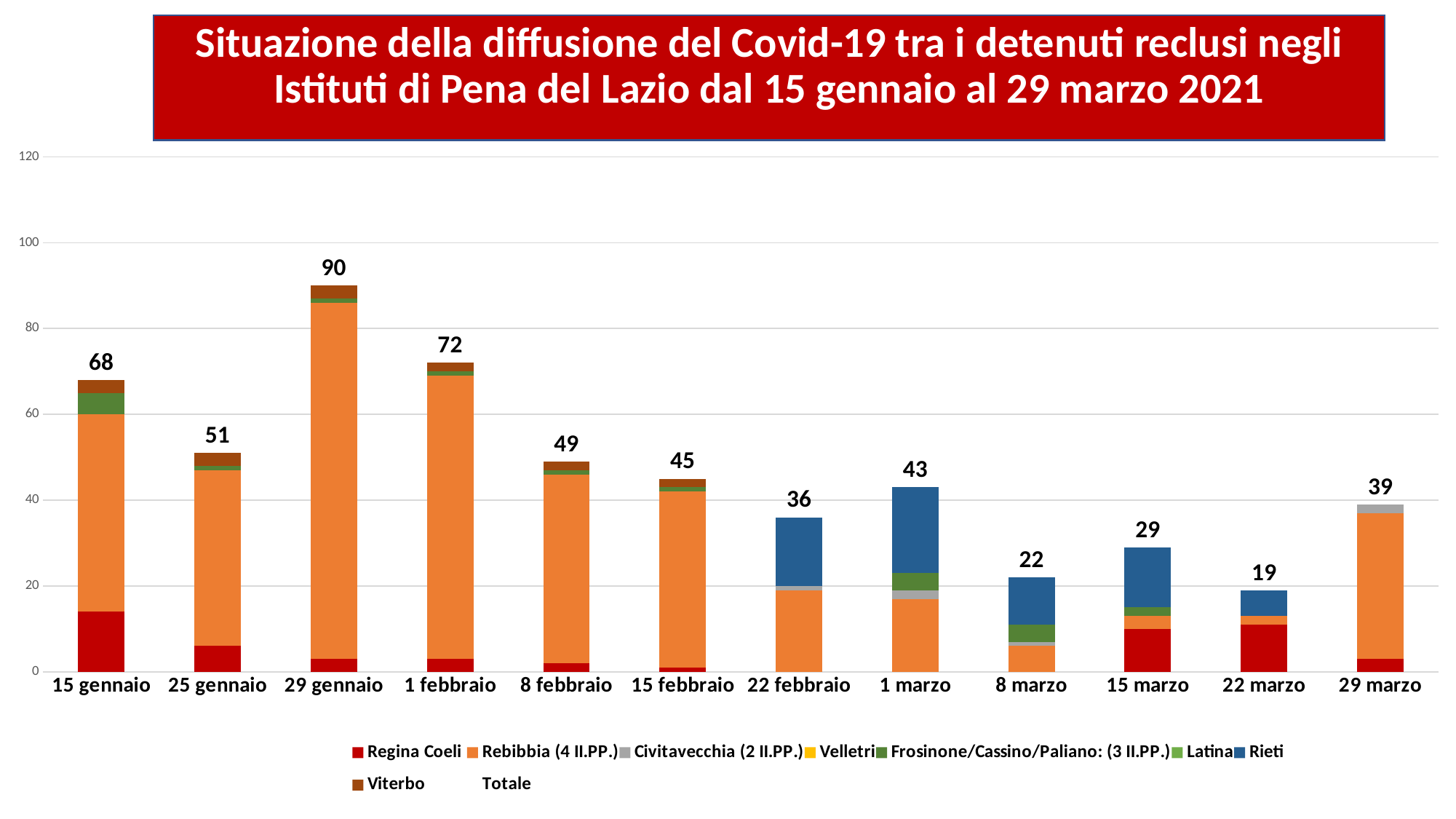
Which date has the highest total? 29 gennaio Do the totals rise or fall from 29 gennaio to 22 marzo? fall How many entries does the legend list? 9 How many dates are shown on the x axis? 12 What is the total value shown for 22 febbraio? 36 What is the difference between the totals for 29 gennaio and 15 gennaio? 22 Which legend entry is shown in blue? Rieti What kind of chart is shown on the slide? stacked bar chart Which date has the lowest total? 22 marzo Is the Regina Coeli value for 15 gennaio greater or less than 20? less What is the total value shown for 29 gennaio? 90 Which has a larger total, 1 marzo or 29 marzo? 1 marzo